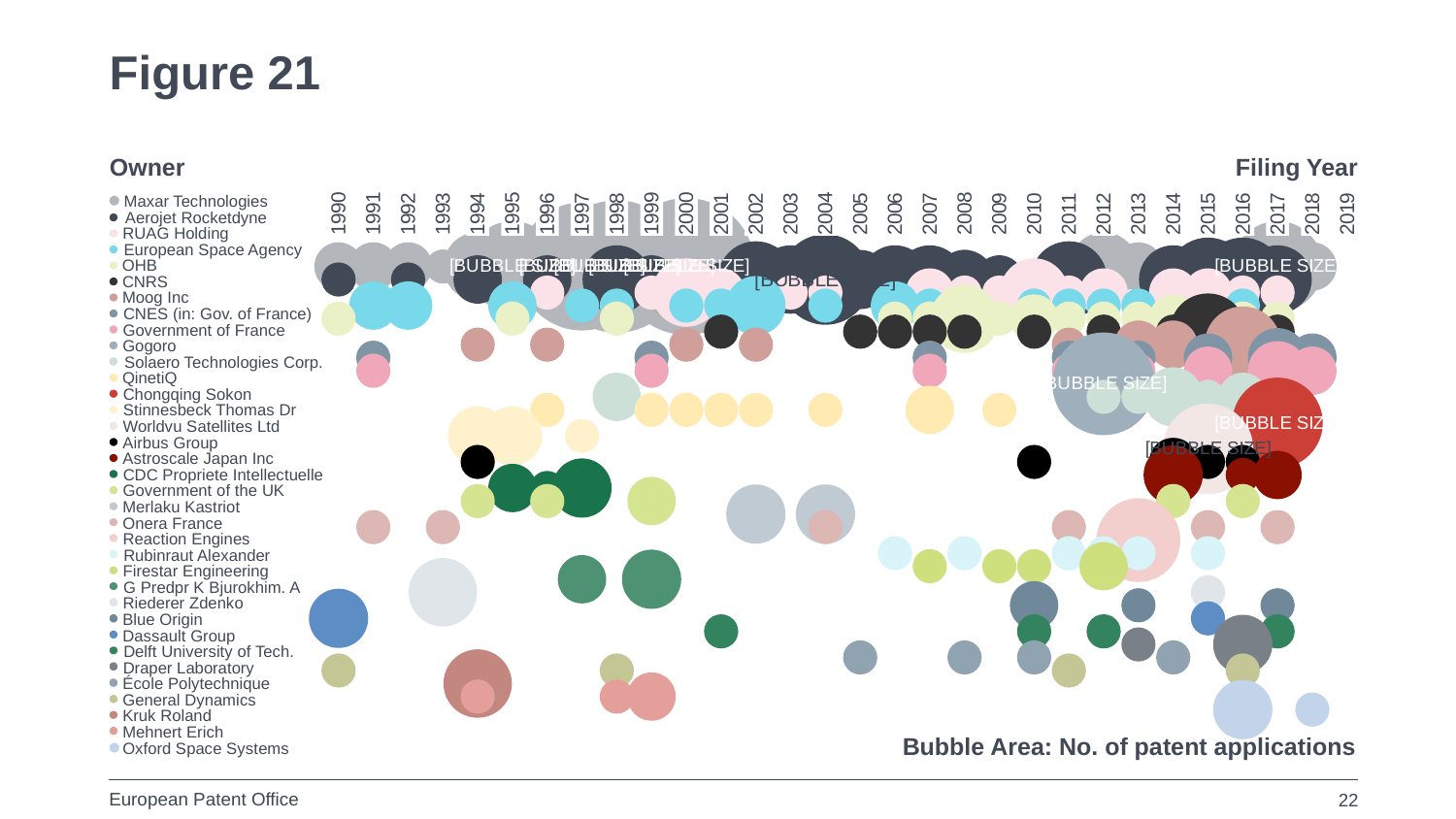
What is the label of the horizontal axis of the chart? Filing Year How many filing years are shown along the x axis of the chart? 30 How many owners are listed on the y axis of the chart? 35 What is the earliest filing year shown on the x axis? 1990 What is the latest filing year shown on the x axis? 2019 What kind of chart is shown on the slide? Bubble chart What does the bubble area represent in the chart? No. of patent applications